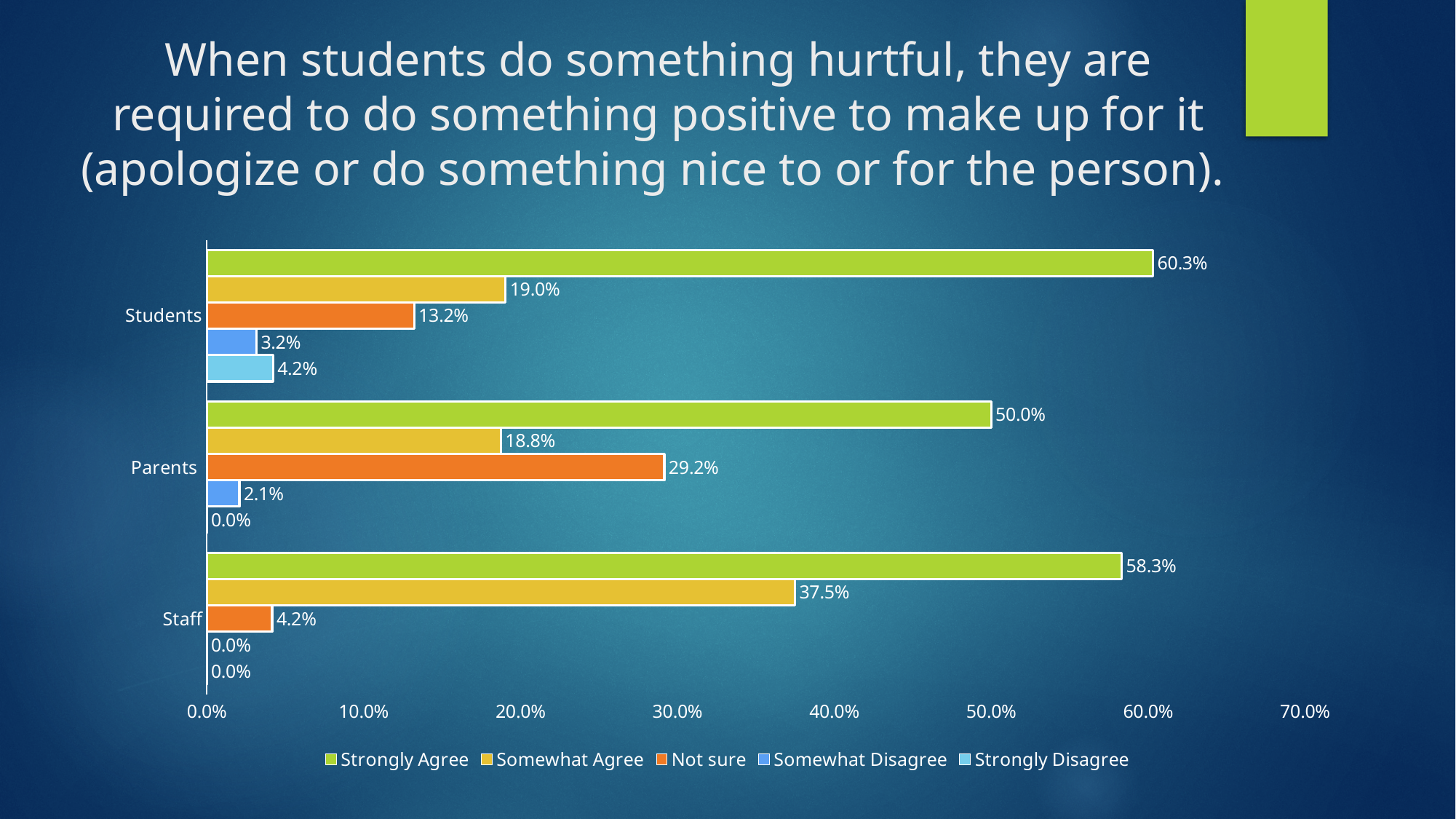
What is the difference between the Strongly Agree values for Students and Parents? 10.3% Which group has the highest Strongly Agree value? Students Which group has the lowest Not sure value? Staff Which colour represents the Not sure series in the legend? Orange Which is larger: the Somewhat Agree value for Staff or the Somewhat Agree value for Students? Staff What is the Strongly Disagree value for Students? 4.2% What is the Somewhat Agree value for Staff? 37.5% How many groups are shown on the vertical axis? 3 What is the Not sure value for Parents? 29.2% What kind of chart is shown on the slide? Bar chart How many series does the legend list? 5 What is the Strongly Agree value for Students? 60.3%